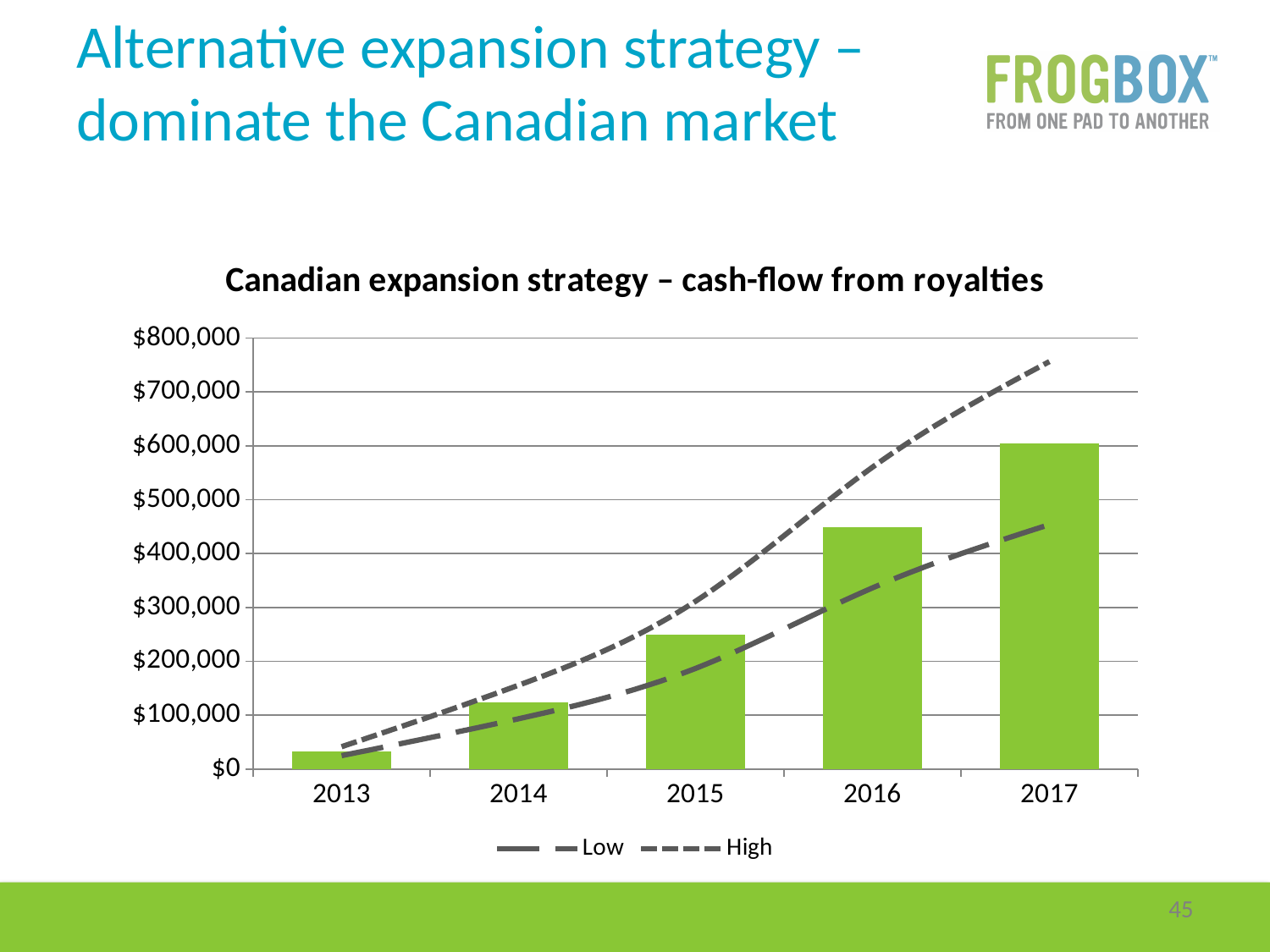
What is the title of the chart? Canadian expansion strategy – cash-flow from royalties Which year has the shortest bar in the chart? 2013 Which year has the tallest bar in the chart? 2017 Do the bar values rise or fall from 2013 to 2017? Rise Is the bar value for 2017 greater or less than $500,000? greater What kind of chart is shown on the slide? A bar chart combined with two dashed line series In 2016, which is larger, the High line value or the Low line value? High Is the High line value for 2017 greater or less than $700,000? greater How many series does the chart's legend list? 2 What are the two series named in the chart's legend? Low and High How many years are shown on the x axis of the chart? 5 Is the bar value for 2016 greater or less than $500,000? less